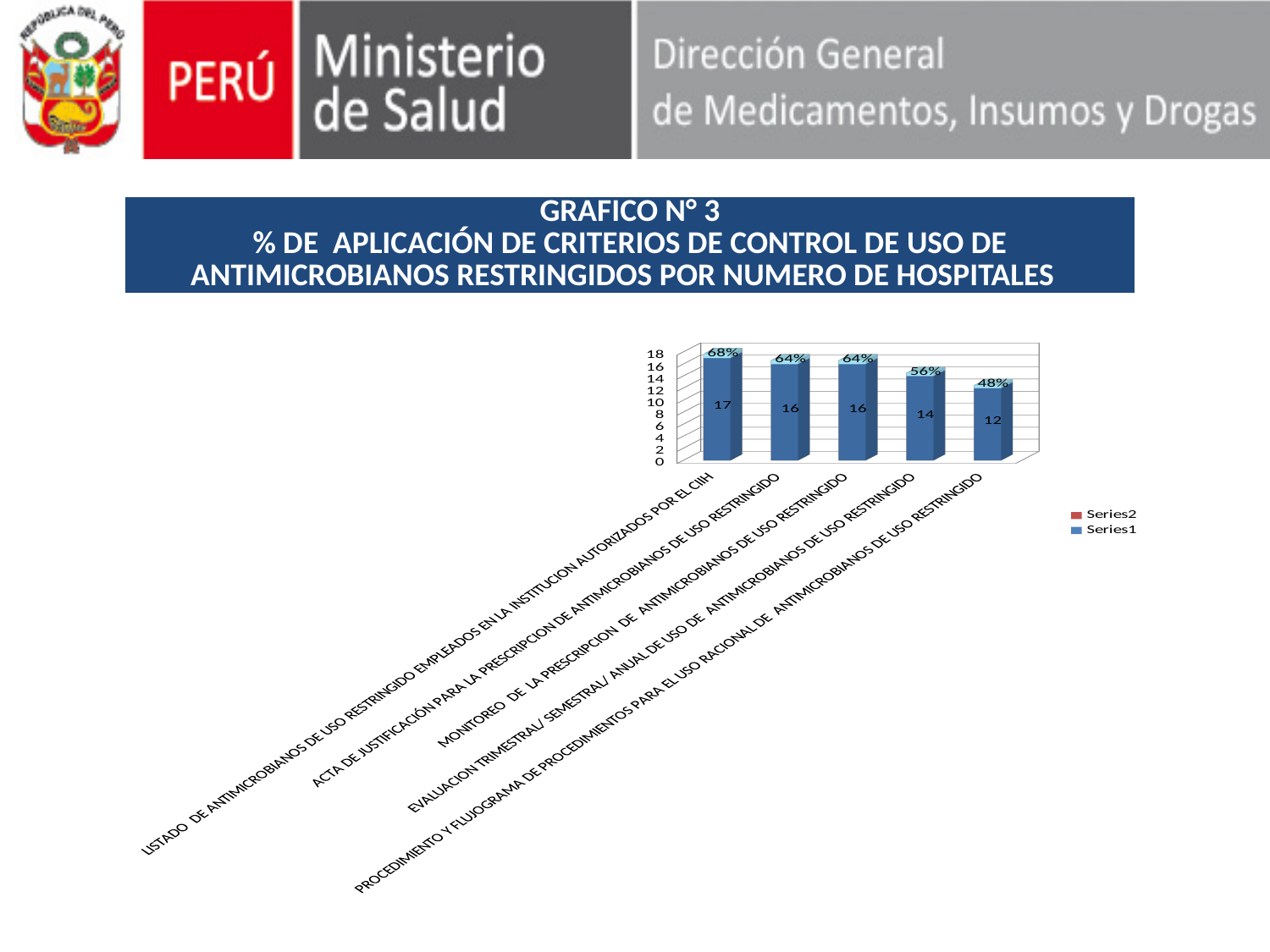
What kind of chart is shown on the slide? Bar chart What is the value for 'EVALUACION TRIMESTRAL/ SEMESTRAL/ ANUAL DE USO DE ANTIMICROBIANOS DE USO RESTRINGIDO'? 14 What is the number of hospitals for 'LISTADO DE ANTIMICROBIANOS DE USO RESTRINGIDO EMPLEADOS EN LA INSTITUCION AUTORIZADOS POR EL CIIH'? 17 What percentage is shown for 'MONITOREO DE LA PRESCRIPCION DE ANTIMICROBIANOS DE USO RESTRINGIDO'? 64% What is the difference between the value for 'LISTADO DE ANTIMICROBIANOS DE USO RESTRINGIDO EMPLEADOS EN LA INSTITUCION AUTORIZADOS POR EL CIIH' and the value for 'PROCEDIMIENTO Y FLUJOGRAMA DE PROCEDIMIENTOS PARA EL USO RACIONAL DE ANTIMICROBIANOS DE USO RESTRINGIDO'? 5 Do the values rise or fall from left to right across the categories? Fall What percentage label is shown on the bar for 'PROCEDIMIENTO Y FLUJOGRAMA DE PROCEDIMIENTOS PARA EL USO RACIONAL DE ANTIMICROBIANOS DE USO RESTRINGIDO'? 48% How many categories are plotted in the chart? 5 Which category has the highest value? LISTADO DE ANTIMICROBIANOS DE USO RESTRINGIDO EMPLEADOS EN LA INSTITUCION AUTORIZADOS POR EL CIIH How many series does the legend list? 2 Which is larger: the value for 'ACTA DE JUSTIFICACIÓN PARA LA PRESCRIPCION DE ANTIMICROBIANOS DE USO RESTRINGIDO' or the value for 'EVALUACION TRIMESTRAL/ SEMESTRAL/ ANUAL DE USO DE ANTIMICROBIANOS DE USO RESTRINGIDO'? ACTA DE JUSTIFICACIÓN PARA LA PRESCRIPCION DE ANTIMICROBIANOS DE USO RESTRINGIDO Which category has the lowest value? PROCEDIMIENTO Y FLUJOGRAMA DE PROCEDIMIENTOS PARA EL USO RACIONAL DE ANTIMICROBIANOS DE USO RESTRINGIDO